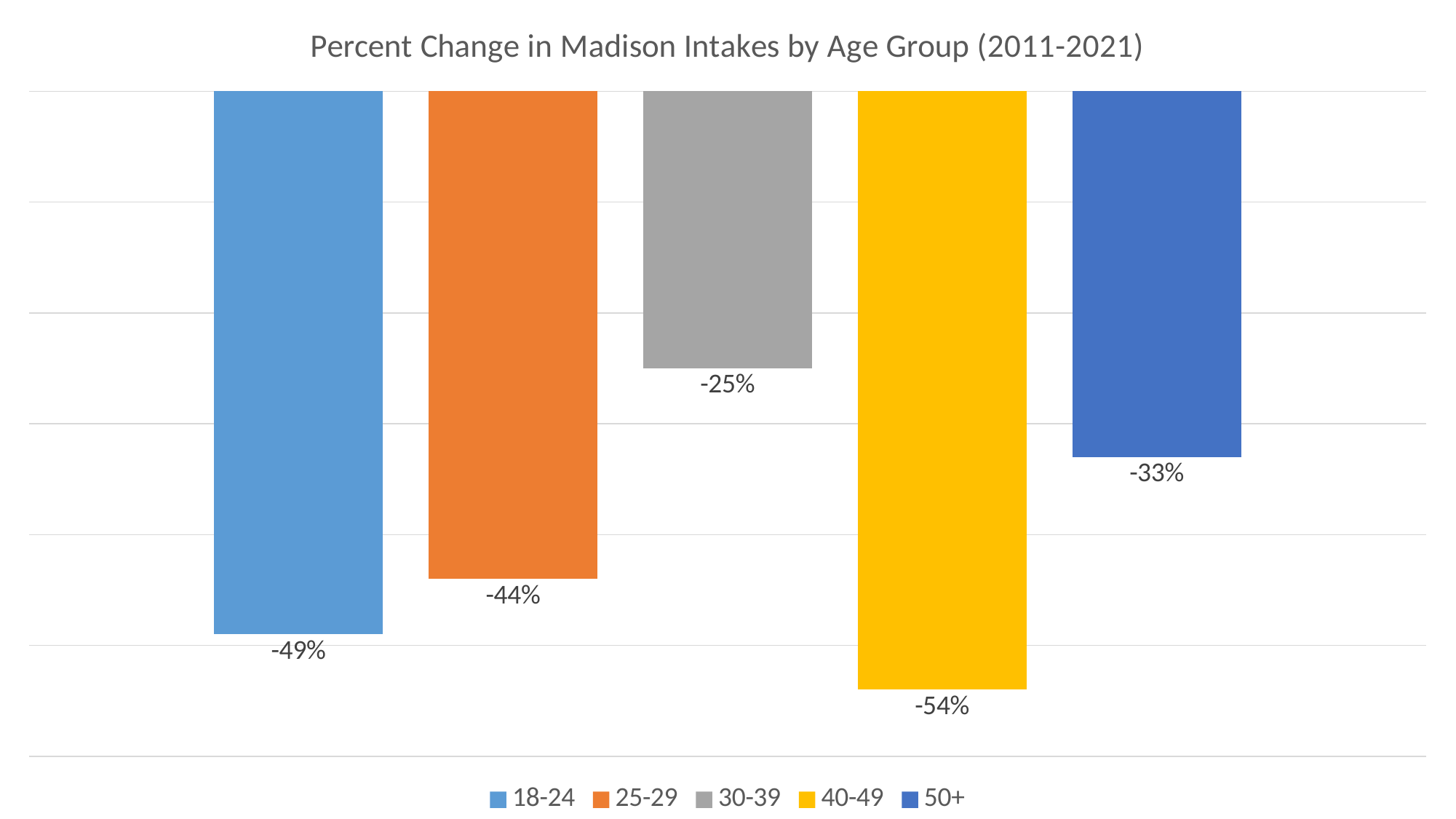
What is the title of the chart? Percent Change in Madison Intakes by Age Group (2011-2021) What type of chart is shown on the slide? Bar chart Which age group shows the largest decrease in Madison intakes? 40-49 What is the percent change in Madison intakes for the 18-24 age group? -49% What is the percent change in Madison intakes for the 25-29 age group? -44% Which age group shows the smallest decrease in Madison intakes? 30-39 What is the difference in percentage points between the 40-49 and 30-39 age groups? 29 percentage points What is the percent change in Madison intakes for the 40-49 age group? -54% How many age groups are shown in the chart? 5 What is the percent change in Madison intakes for the 50+ age group? -33% Which age group had a larger decrease in intakes, 18-24 or 25-29? 18-24 What is the percent change in Madison intakes for the 30-39 age group? -25%